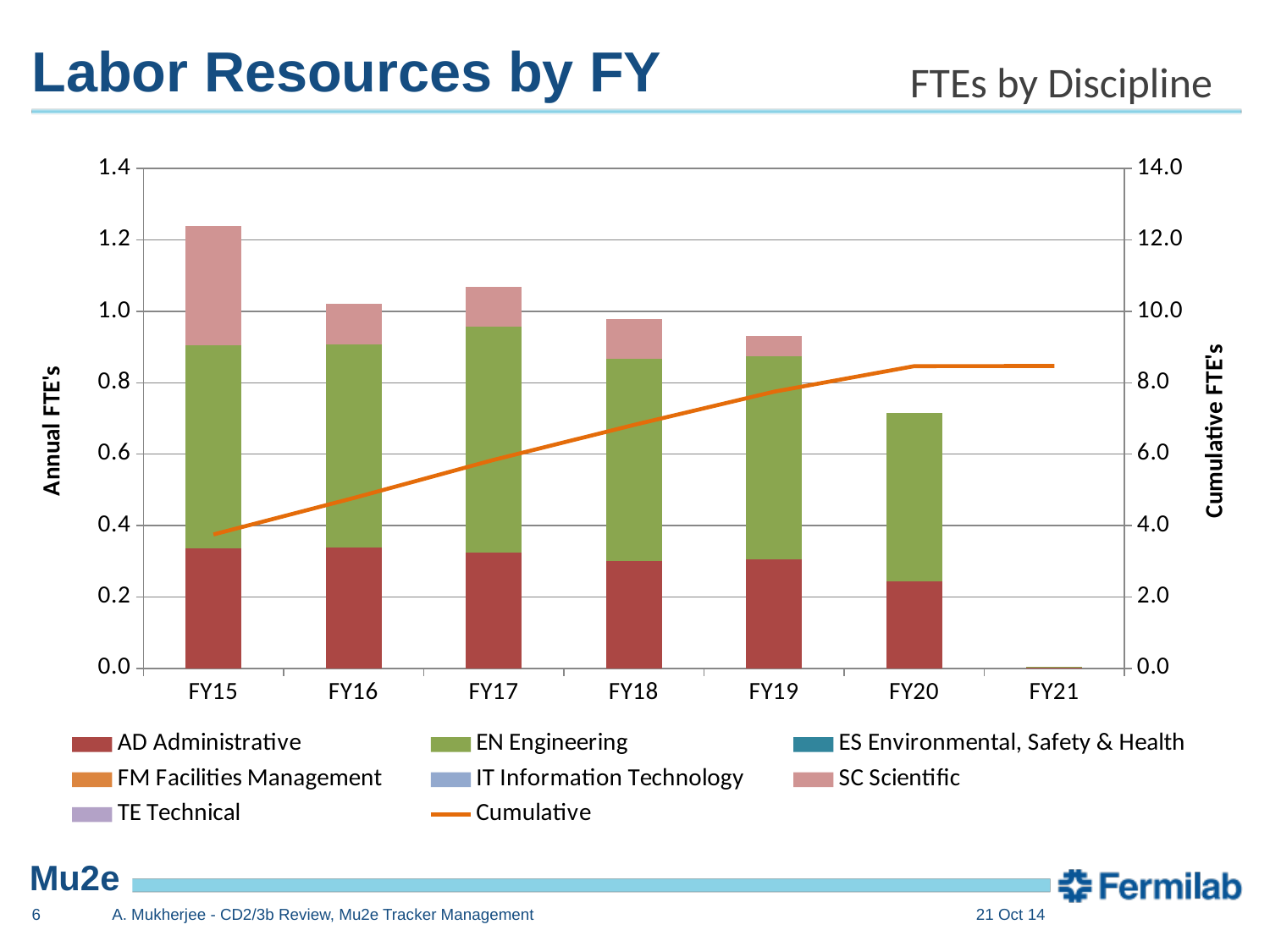
Which fiscal year has the lowest total bar? FY21 Is the total annual FTE value for FY15 greater or less than 1.0? greater Which has the larger total bar, FY17 or FY19? FY17 What kind of chart is shown on the slide? bar chart (stacked, with a cumulative line) Is the Cumulative value for FY15 greater or less than 4.0? less Does the Cumulative line rise or fall from FY15 to FY20? rises How many entries does the legend list? 8 What is the title of the right-hand vertical axis? Cumulative FTE's How many fiscal years are shown on the x axis? 7 Is the total annual FTE value for FY20 greater or less than 0.8? less Which fiscal year has the tallest total bar? FY15